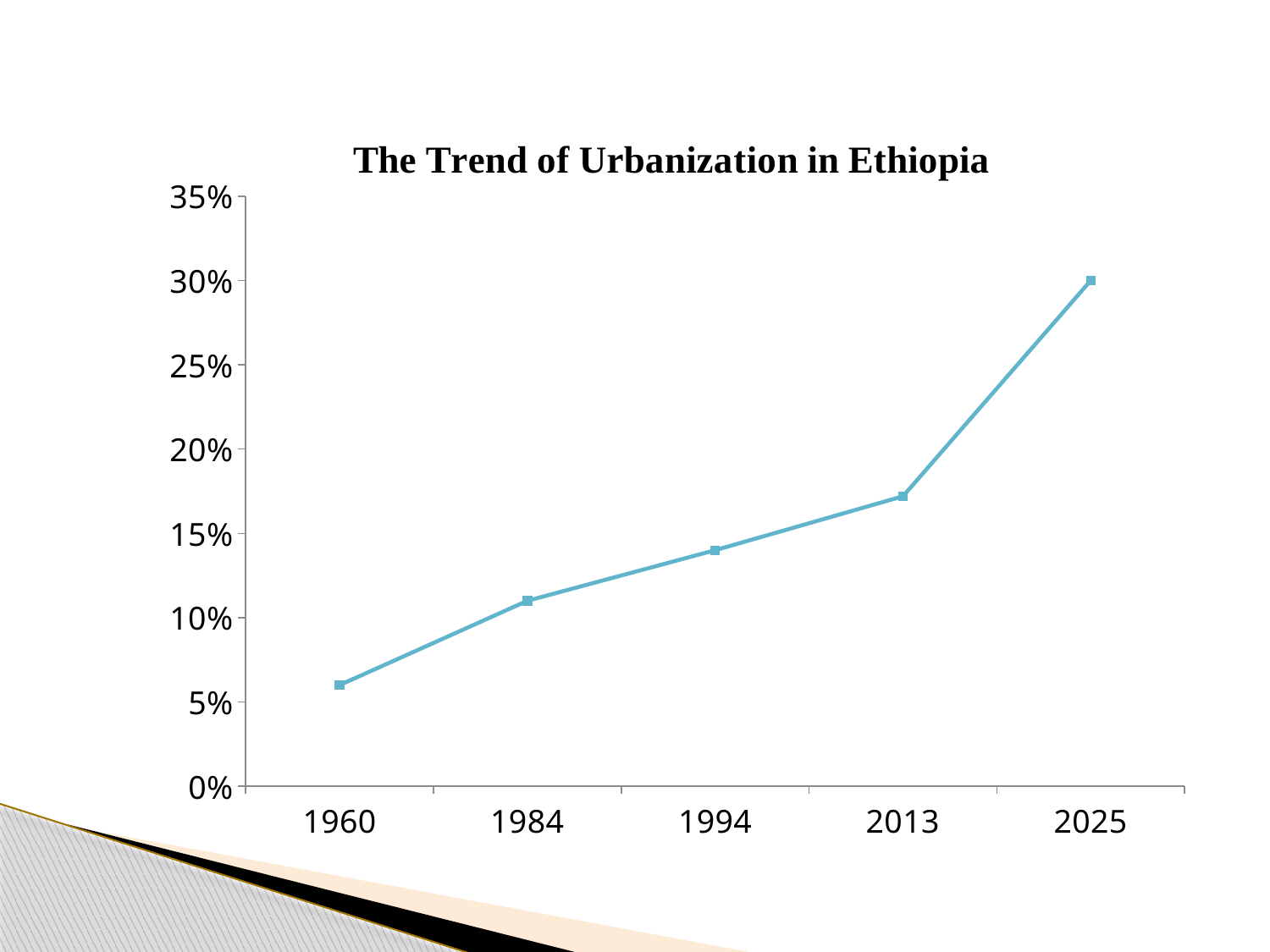
What is the title of the chart? The Trend of Urbanization in Ethiopia Do the values rise or fall from 1960 to 2025? rise Which year has the larger value, 1984 or 2013? 2013 How many years are plotted on the x axis? 5 Is the value for 2013 greater or less than 20%? less What kind of chart is shown on the slide? line chart Which year has the lowest urbanization value? 1960 Which year has the highest urbanization value? 2025 Is the value for 1960 greater or less than 10%? less Is the value for 1984 greater or less than 10%? greater